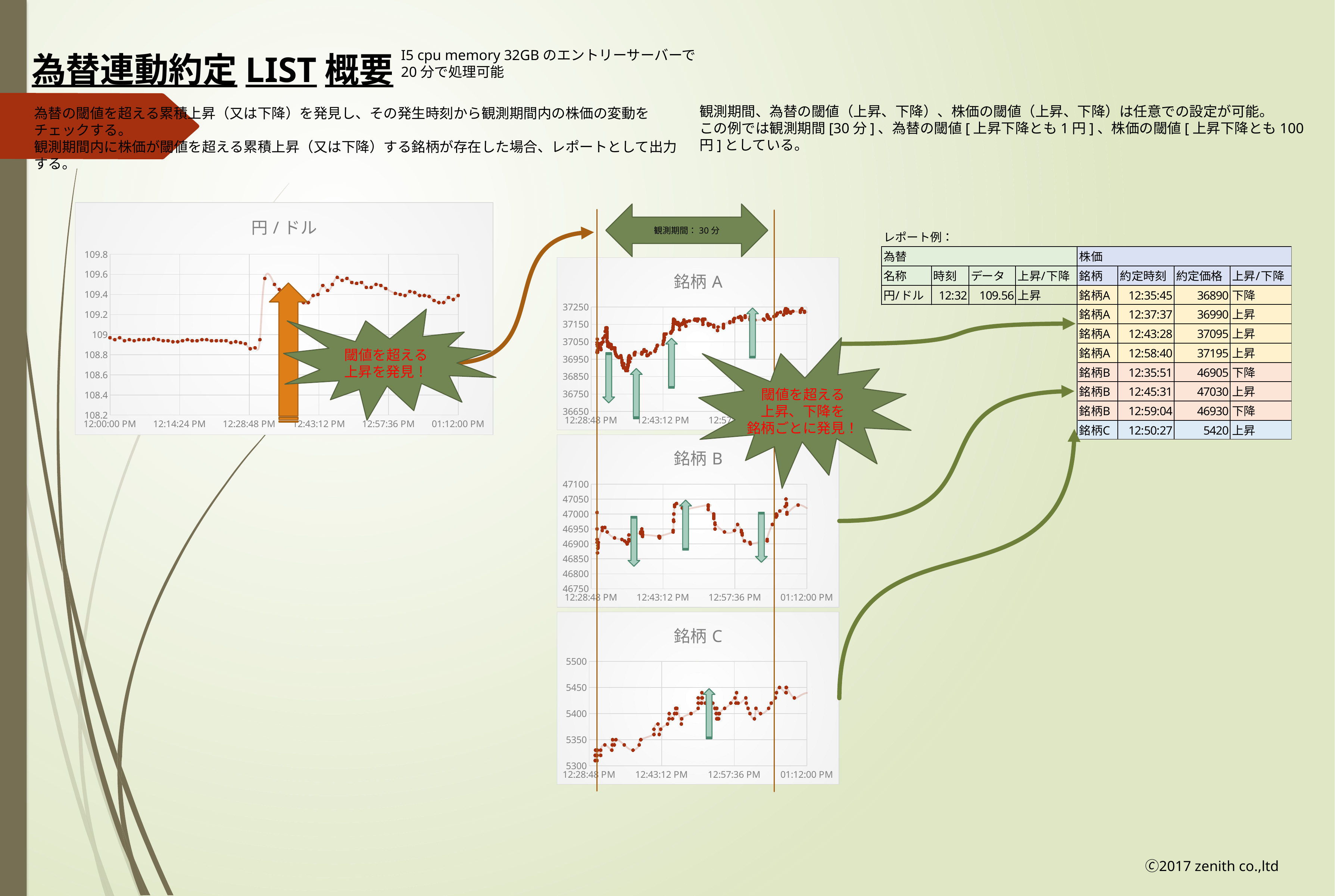
In the 銘柄 C chart, is the value at 12:28:48 PM greater or less than 5350? less What is the title of the chart on the left side of the slide? 円 / ドル What is the highest value shown on the y axis of the 円 / ドル chart? 109.8 In the 銘柄 C chart, do the values overall rise or fall from 12:28:48 PM to 01:12:00 PM? rise In the 円 / ドル chart, do the values overall rise or fall from 12:00:00 PM to 01:12:00 PM? rise In the 銘柄 B chart, is the value at 01:12:00 PM greater or less than 46950? greater What kind of chart is the 銘柄 A chart? scatter chart In the 円 / ドル chart, is the value at 01:12:00 PM greater or less than 109.2? greater How many charts are shown on the slide? 4